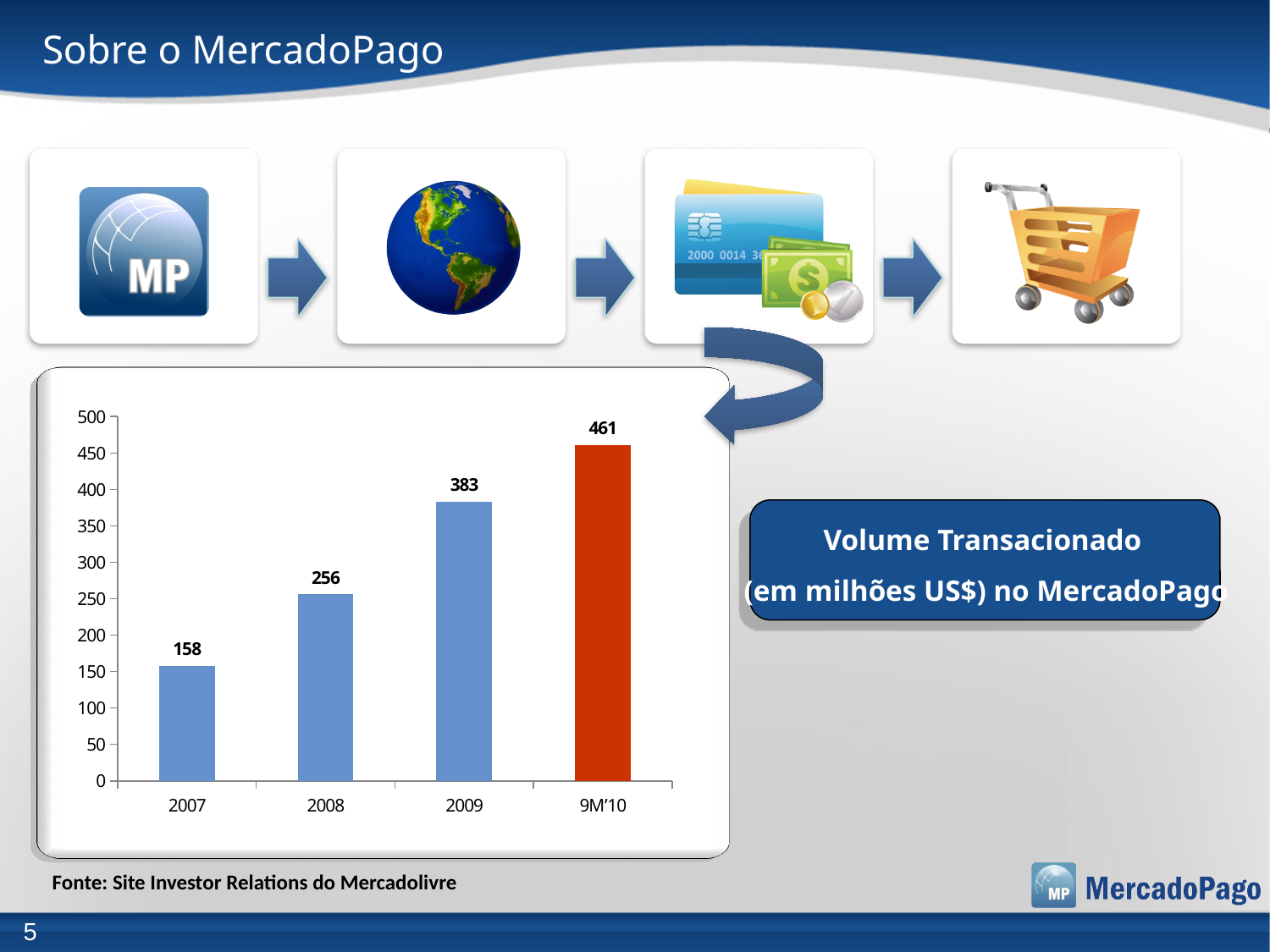
Is the value for 2008 greater or less than 300? less Which category has the highest value in the chart? 9M'10 What is the transaction volume shown for 2009? 383 What is the difference between the values for 2009 and 2008? 127 What is the difference between the values for 9M'10 and 2007? 303 Do the values rise or fall from 2007 to 9M'10? rise Which category has the lowest value in the chart? 2007 What is the transaction volume shown for 2007? 158 Which is larger, the value for 2008 or the value for 2009? 2009 How many categories are shown on the x axis of the chart? 4 What value is shown for 9M'10? 461 What kind of chart is shown on the slide? bar chart